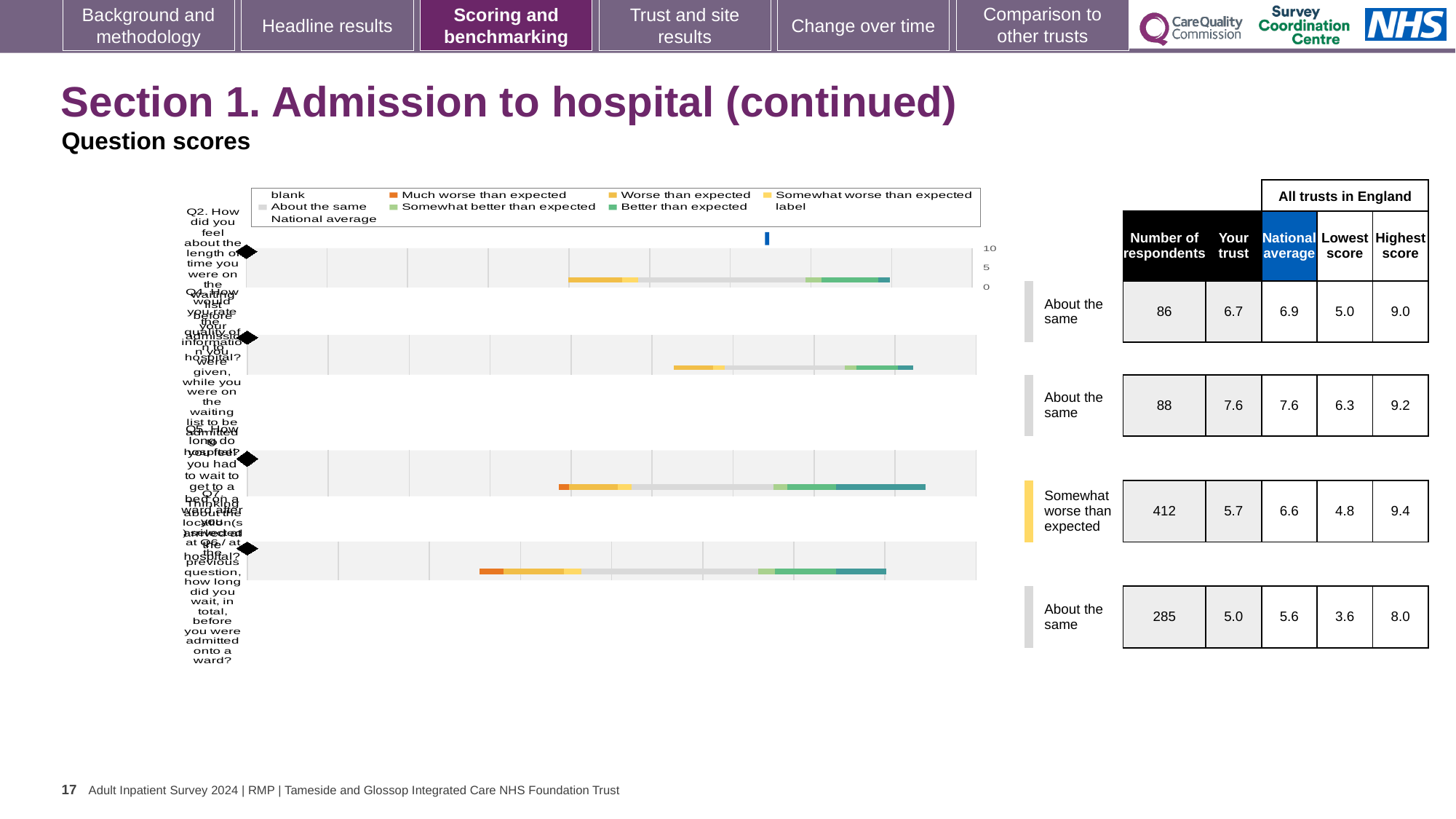
In the table, what is the number of respondents in the first row? 86 In the row labelled 'Somewhat worse than expected', what is the difference between the national average and the 'Your trust' score? 0.9 What is the highest score shown in the last row of the table? 8.0 Which row of the table has the highest number of respondents? Somewhat worse than expected (412) In the table, what is the 'Your trust' score for the row labelled 'Somewhat worse than expected'? 5.7 What kind of chart is shown on the slide? bar chart What is the lowest 'Your trust' score shown in the table? 5.0 In the first row of the table, which is larger: the 'Your trust' score or the national average? National average How many question bars are plotted in the chart? 4 Which colour in the legend represents 'Much worse than expected'? Orange In the table, what is the national average for the row with 412 respondents? 6.6 What is the lowest score shown in the second row of the table? 6.3